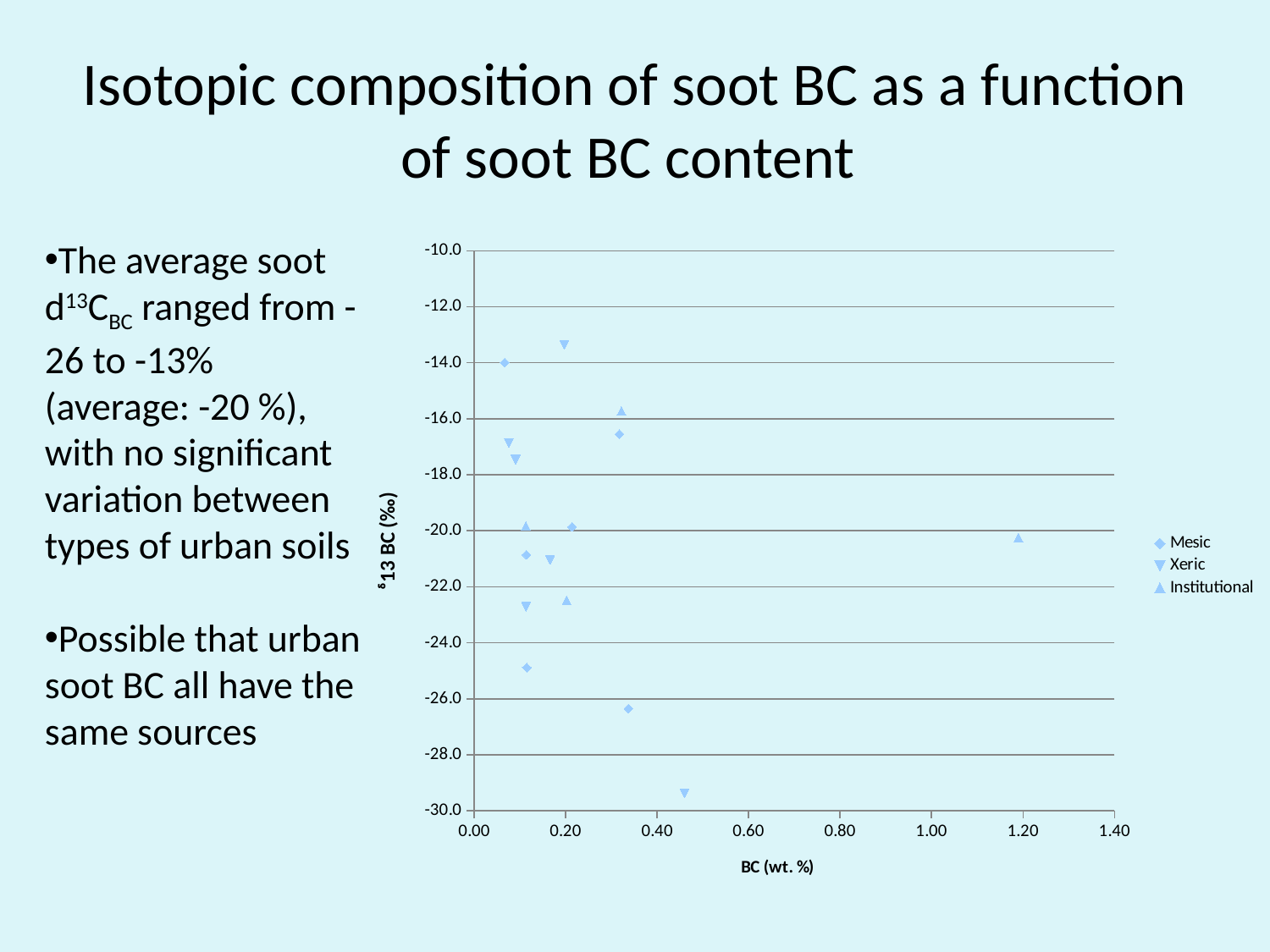
Which series contains the point with the largest BC (wt. %) value on the chart? Institutional How many Institutional points are plotted on the chart? 4 Is the δ13 BC value of the highest Xeric point greater or less than -14.0? greater Is the δ13 BC value of the lowest Xeric point greater or less than -28.0? less What is the title of the x axis of the chart? BC (wt. %) Which series contains the point with the lowest δ13 BC value on the chart? Xeric Which series has the point with the highest δ13 BC value, Xeric or Institutional? Xeric What are the three series named in the chart legend? Mesic, Xeric, Institutional What is the maximum value shown on the x axis of the chart? 1.40 How many series does the chart legend list? 3 What kind of chart is shown on the slide? Scatter chart Is the BC (wt. %) value of the rightmost Institutional point greater or less than 1.00? greater